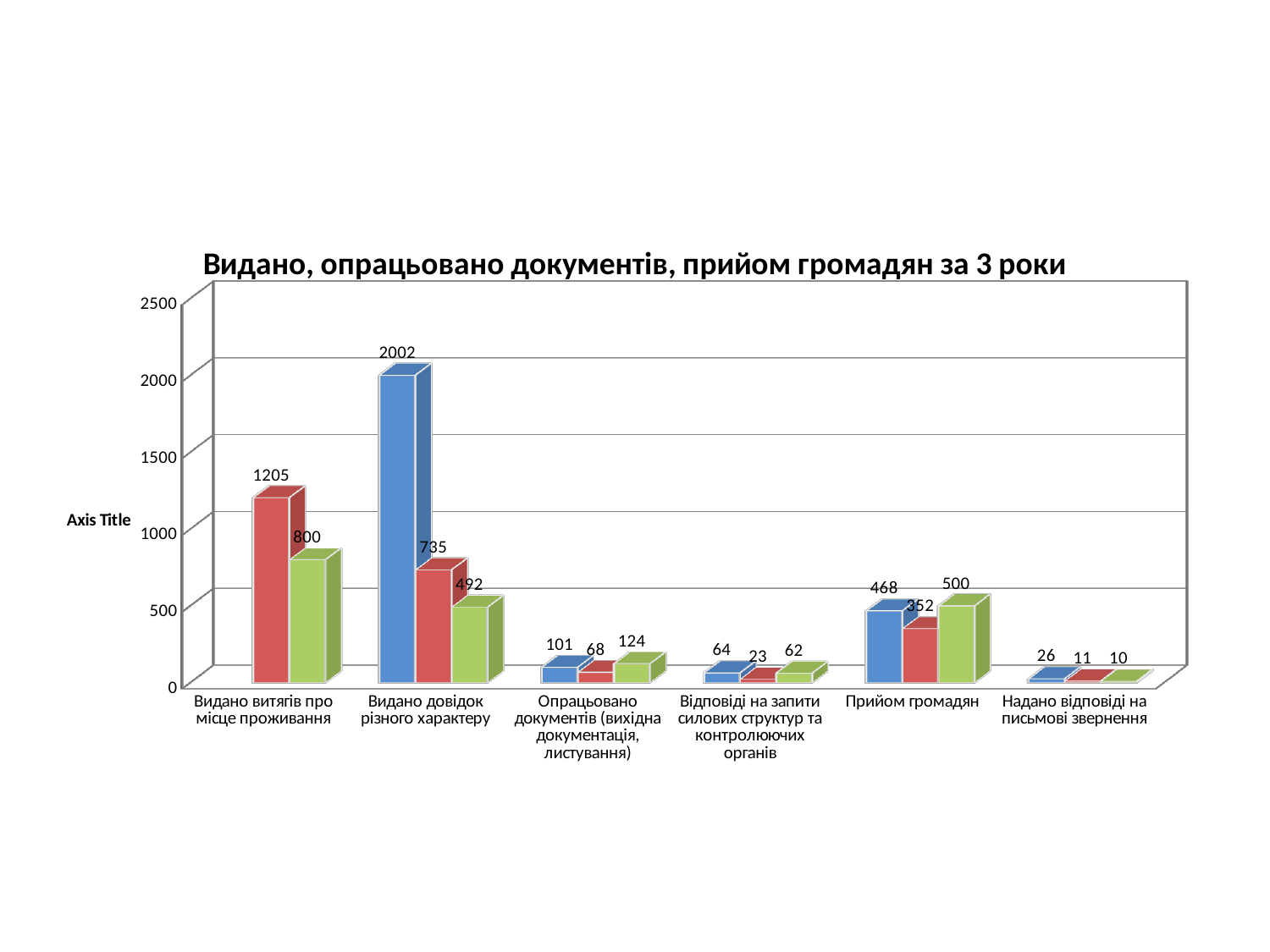
What is the value of the red bar for "Відповіді на запити силових структур та контролюючих органів"? 23 What is the value of the red bar for "Видано витягів про місце проживання"? 1205 Which category has the highest single bar in the chart? Видано довідок різного характеру For "Опрацьовано документів (вихідна документація, листування)", which is larger: the blue bar or the green bar? the green bar (124) What is the title of the chart? Видано, опрацьовано документів, прийом громадян за 3 роки How many categories are shown on the x axis of the chart? 6 What type of chart is shown on the slide? bar chart Is the red bar for "Видано витягів про місце проживання" greater or less than 1000? greater What is the difference between the blue bar (2002) and the red bar (735) for "Видано довідок різного характеру"? 1267 What is the value of the blue bar for "Видано довідок різного характеру"? 2002 Which category has the lowest bars overall in the chart? Надано відповіді на письмові звернення What is the value of the green bar for "Прийом громадян"? 500